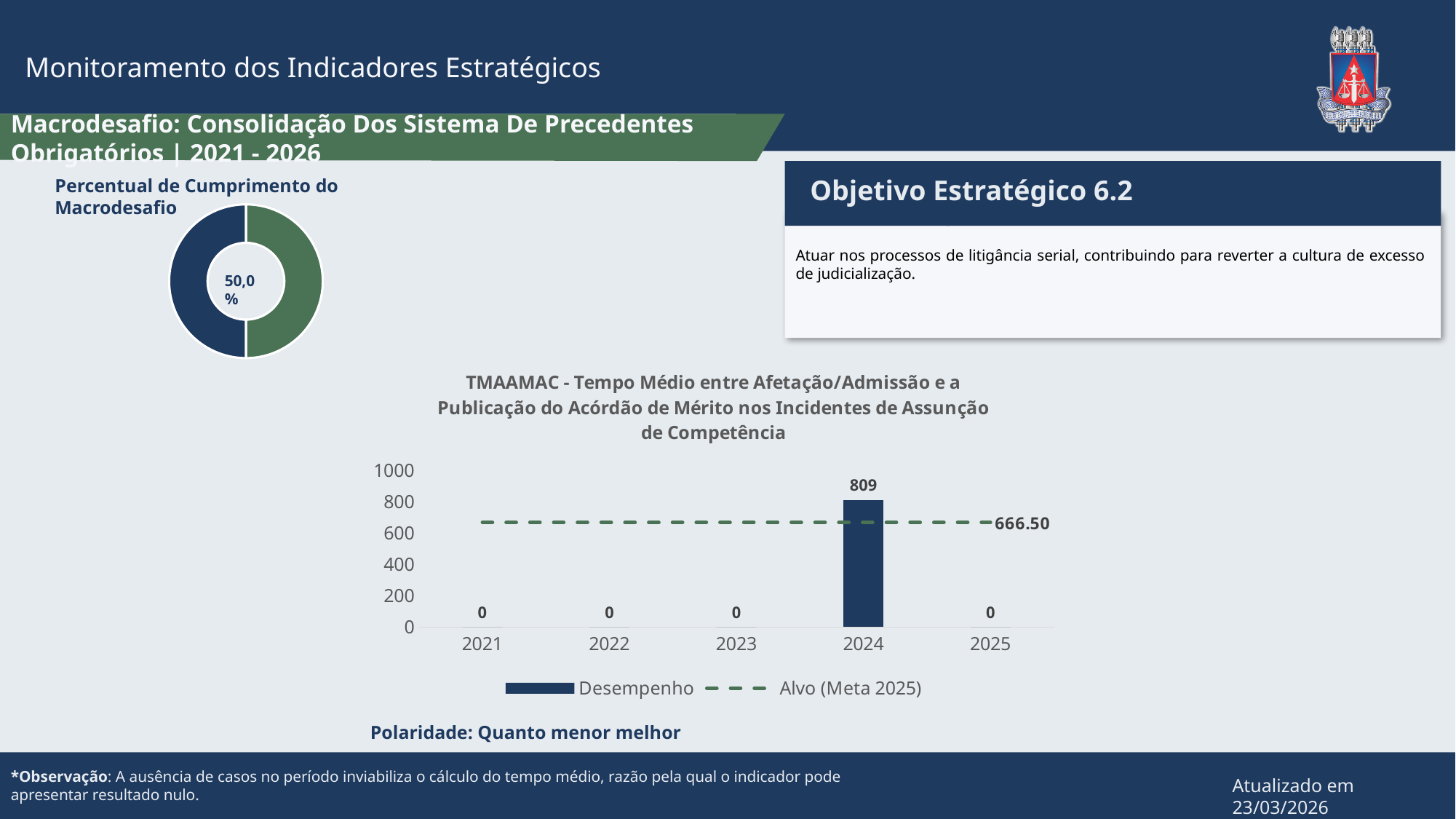
In the TMAAMAC chart, how many series does the legend list? 2 In the TMAAMAC chart, what is the difference between the 2024 Desempenho value and the Alvo (Meta 2025) value? 142.50 In the TMAAMAC chart, how many years are shown on the x axis? 5 In the TMAAMAC chart, what is the Desempenho value for 2022? 0 What kind of chart is the Percentual de Cumprimento do Macrodesafio chart? donut chart In the TMAAMAC chart, what is the value of the Alvo (Meta 2025) line? 666.50 In the TMAAMAC chart, what is the Desempenho value for 2024? 809 In the TMAAMAC chart, is the 2024 Desempenho value greater or less than the Alvo (Meta 2025) value? greater In the Percentual de Cumprimento do Macrodesafio chart, what percentage is shown in the centre? 50,0% In the TMAAMAC chart, is the 2024 Desempenho value greater or less than 1000? less What kind of chart is the TMAAMAC chart? combination bar and line chart In the TMAAMAC chart, which year has the highest Desempenho value? 2024